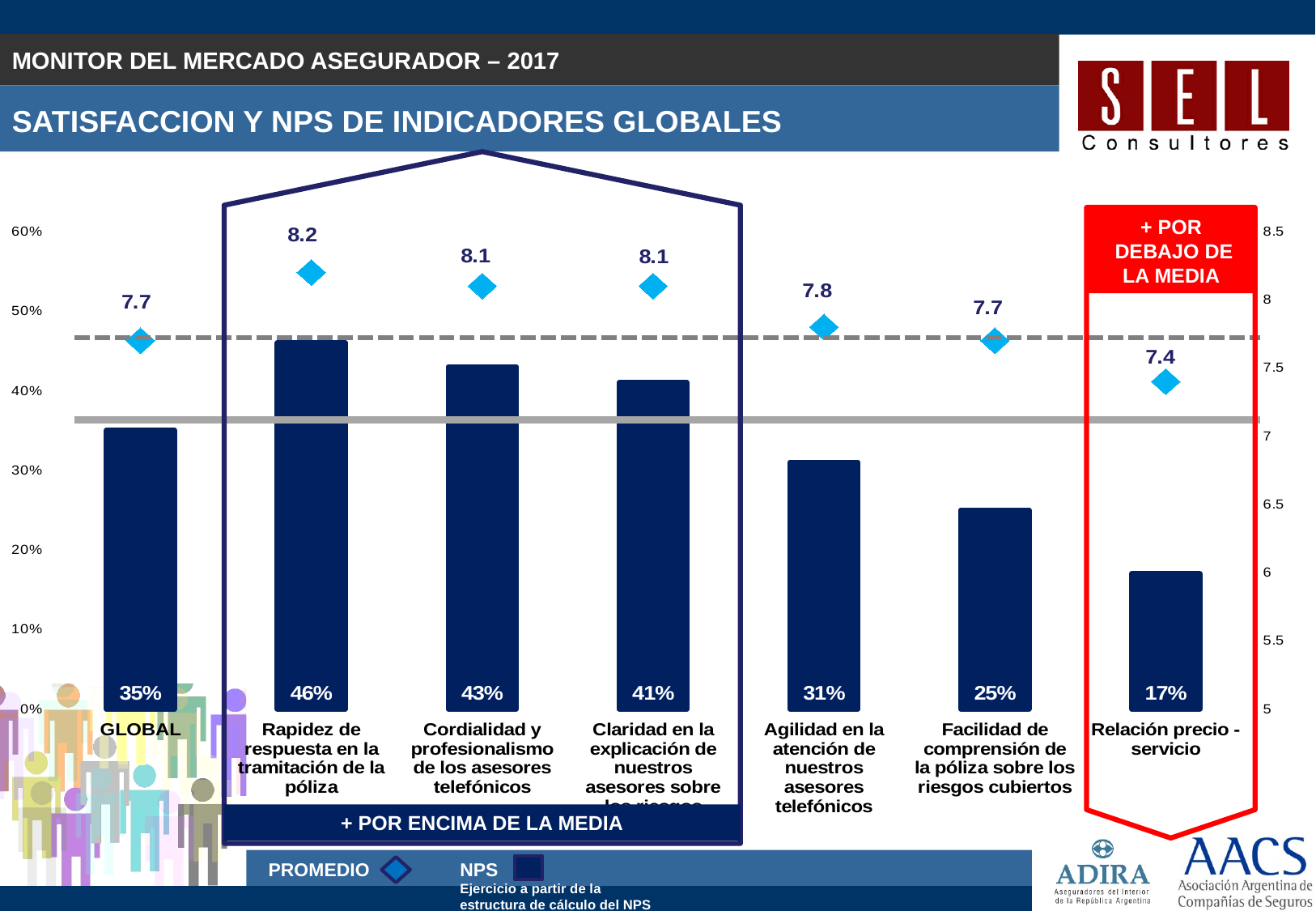
Which category has the highest NPS bar? Rapidez de respuesta en la tramitación de la póliza What is the NPS value for Agilidad en la atención de nuestros asesores telefónicos? 31% Which category has the lowest PROMEDIO value? Relación precio - servicio Which series is represented by the diamond markers in the legend? PROMEDIO How many series does the legend list? 2 What is the PROMEDIO value for Cordialidad y profesionalismo de los asesores telefónicos? 8.1 What kind of chart is this? Combined bar and marker (diamond) chart How many categories are shown on the x axis? 7 Which has a higher PROMEDIO value, Agilidad en la atención de nuestros asesores telefónicos or Facilidad de comprensión de la póliza sobre los riesgos cubiertos? Agilidad en la atención de nuestros asesores telefónicos What is the PROMEDIO value for Relación precio - servicio? 7.4 What is the difference in NPS between Rapidez de respuesta en la tramitación de la póliza and Relación precio - servicio? 29% What is the NPS value for GLOBAL? 35%